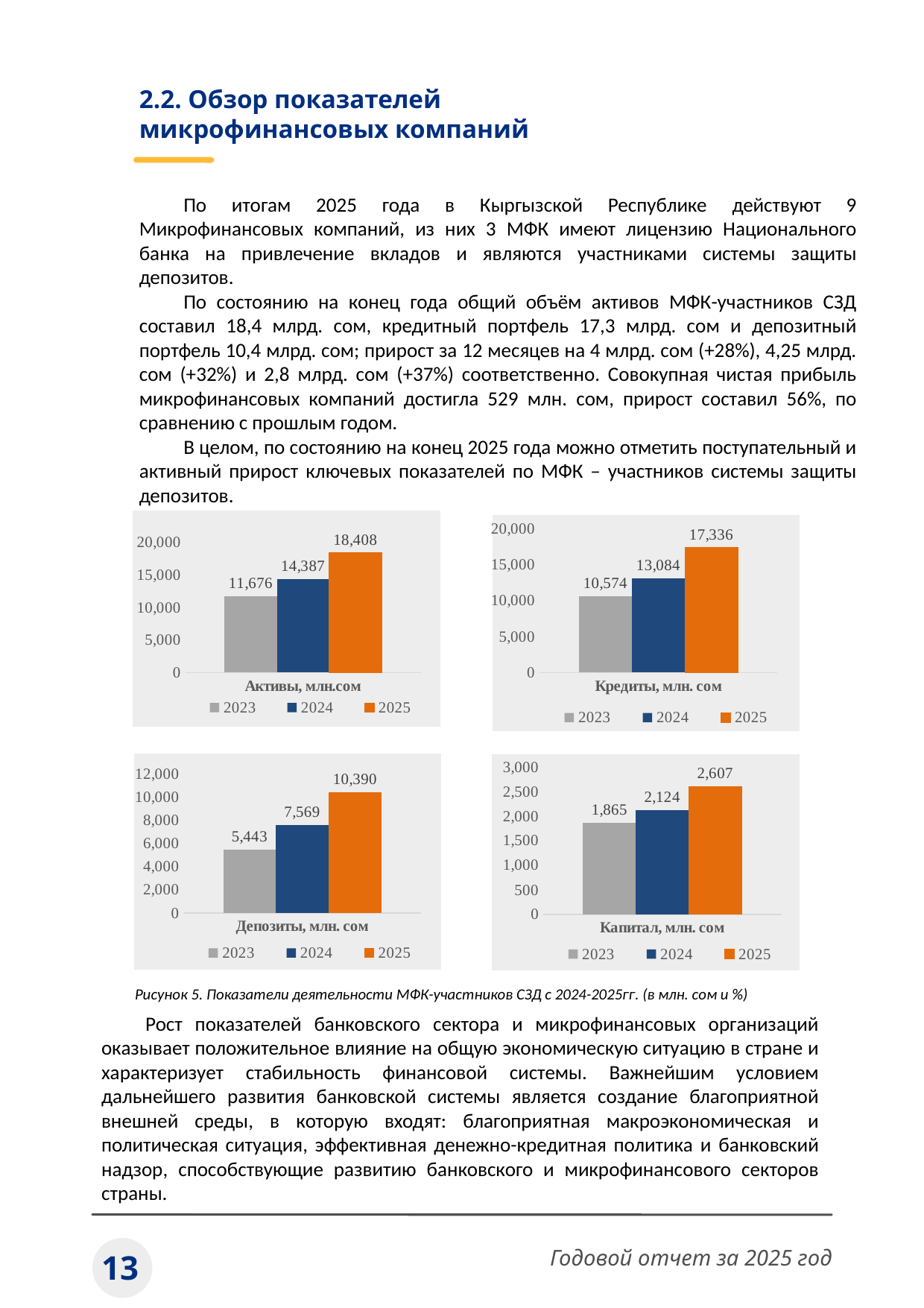
In the 'Депозиты, млн. сом' chart, what is the value for 2024? 7,569 In the 'Депозиты, млн. сом' chart, do the values rise or fall from 2023 to 2025? rise In the 'Активы, млн.сом' chart, which is larger: the value for 2024 or the value for 2023? 2024 In the 'Капитал, млн. сом' chart, what is the difference between the 2024 and 2023 values? 259 In the 'Кредиты, млн. сом' chart, what is the value for 2023? 10,574 What kind of chart is the 'Капитал, млн. сом' chart? bar chart How many series does the legend of the 'Кредиты, млн. сом' chart list? 3 In the 'Активы, млн.сом' chart, which year has the lowest value? 2023 In the 'Кредиты, млн. сом' chart, what is the difference between the 2025 and 2024 values? 4,252 In the 'Капитал, млн. сом' chart, what is the value for 2025? 2,607 In the 'Депозиты, млн. сом' chart, which year has the highest value? 2025 In the 'Активы, млн.сом' chart, what is the value for 2025? 18,408